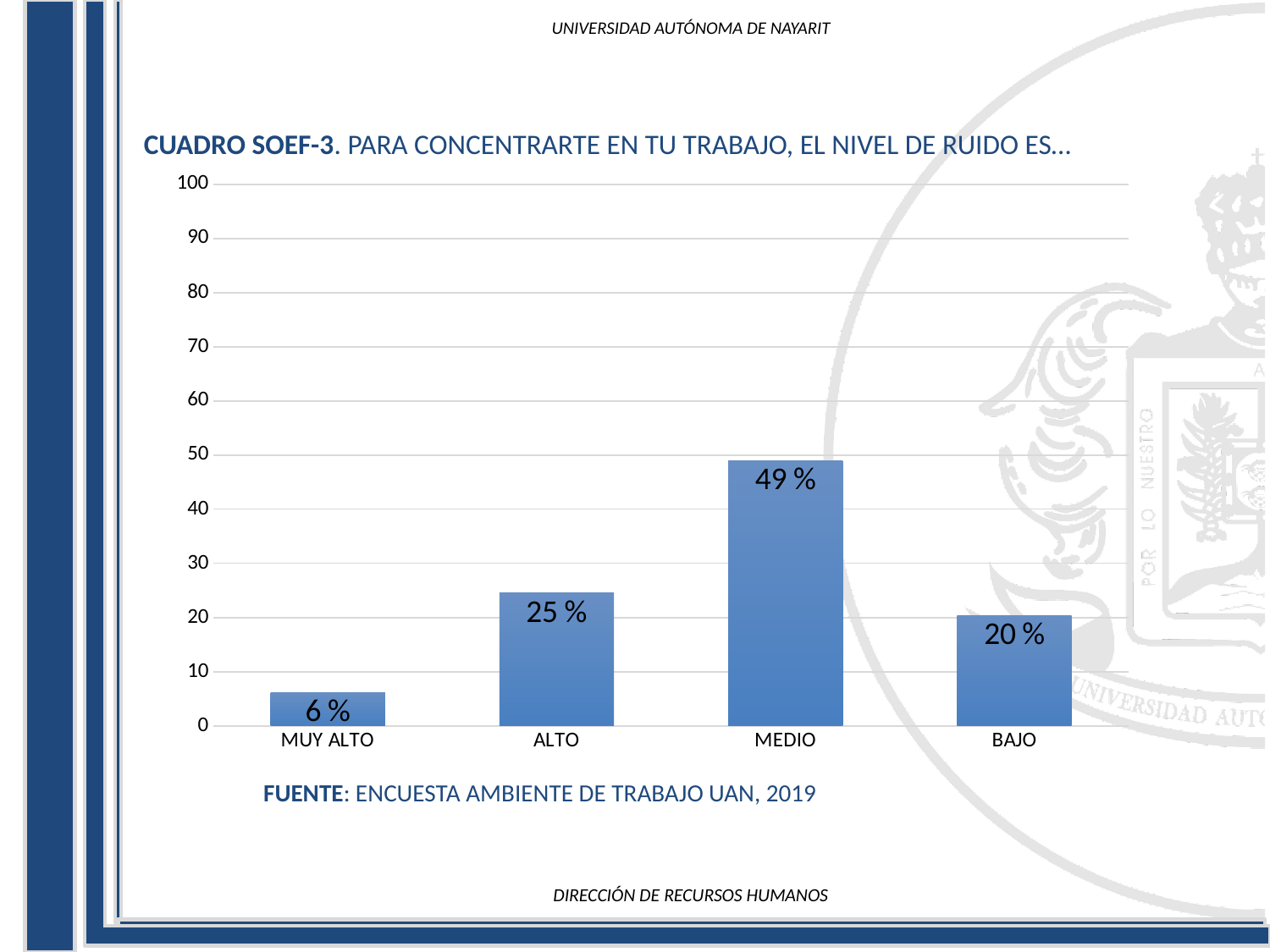
What kind of chart is shown on the slide? bar chart What is the difference between the values for MEDIO and ALTO? 24 % Which category has the lowest value? MUY ALTO What is the value for MUY ALTO? 6 % Which category has the highest value? MEDIO What source is cited below the chart? ENCUESTA AMBIENTE DE TRABAJO UAN, 2019 How many categories are shown on the x axis? 4 Is the value for MEDIO greater or less than 40? greater What is the title of the chart? CUADRO SOEF-3. PARA CONCENTRARTE EN TU TRABAJO, EL NIVEL DE RUIDO ES… What is the value for BAJO? 20 % Which is larger, the value for ALTO or the value for BAJO? ALTO What is the value for MEDIO? 49 %